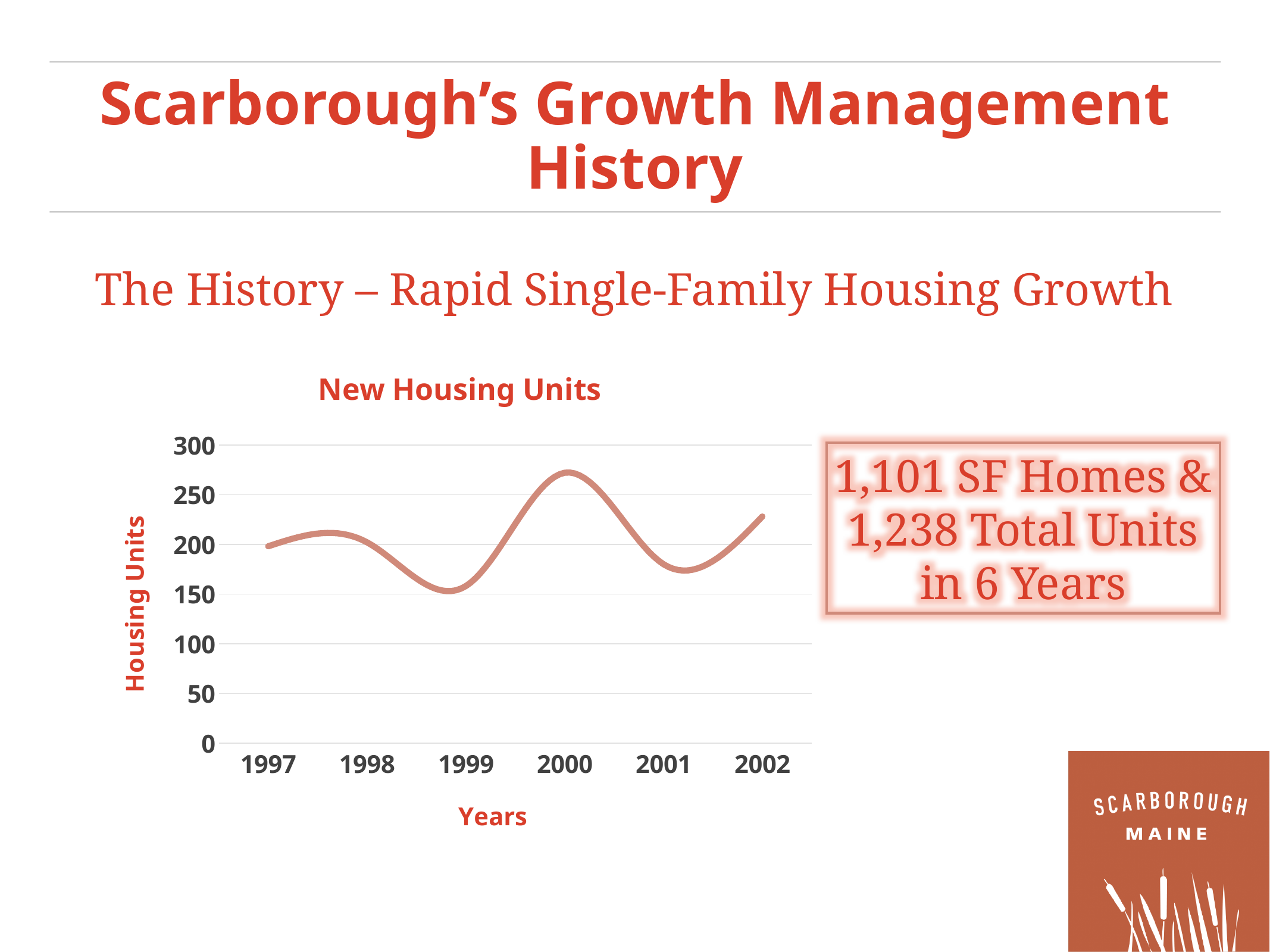
Is the value for 1999 greater or less than 200? less What type of chart is shown on the slide? line chart Is the value for 2001 greater or less than 150? greater Which year has more new housing units, 1999 or 2000? 2000 Which year has the highest number of new housing units? 2000 What is the title of the chart? New Housing Units How many years are plotted on the x axis of the chart? 6 Do new housing units rise or fall from 2000 to 2001? fall Is the value for 2000 greater or less than 250? greater What is the label of the vertical axis of the chart? Housing Units Which year has the lowest number of new housing units? 1999